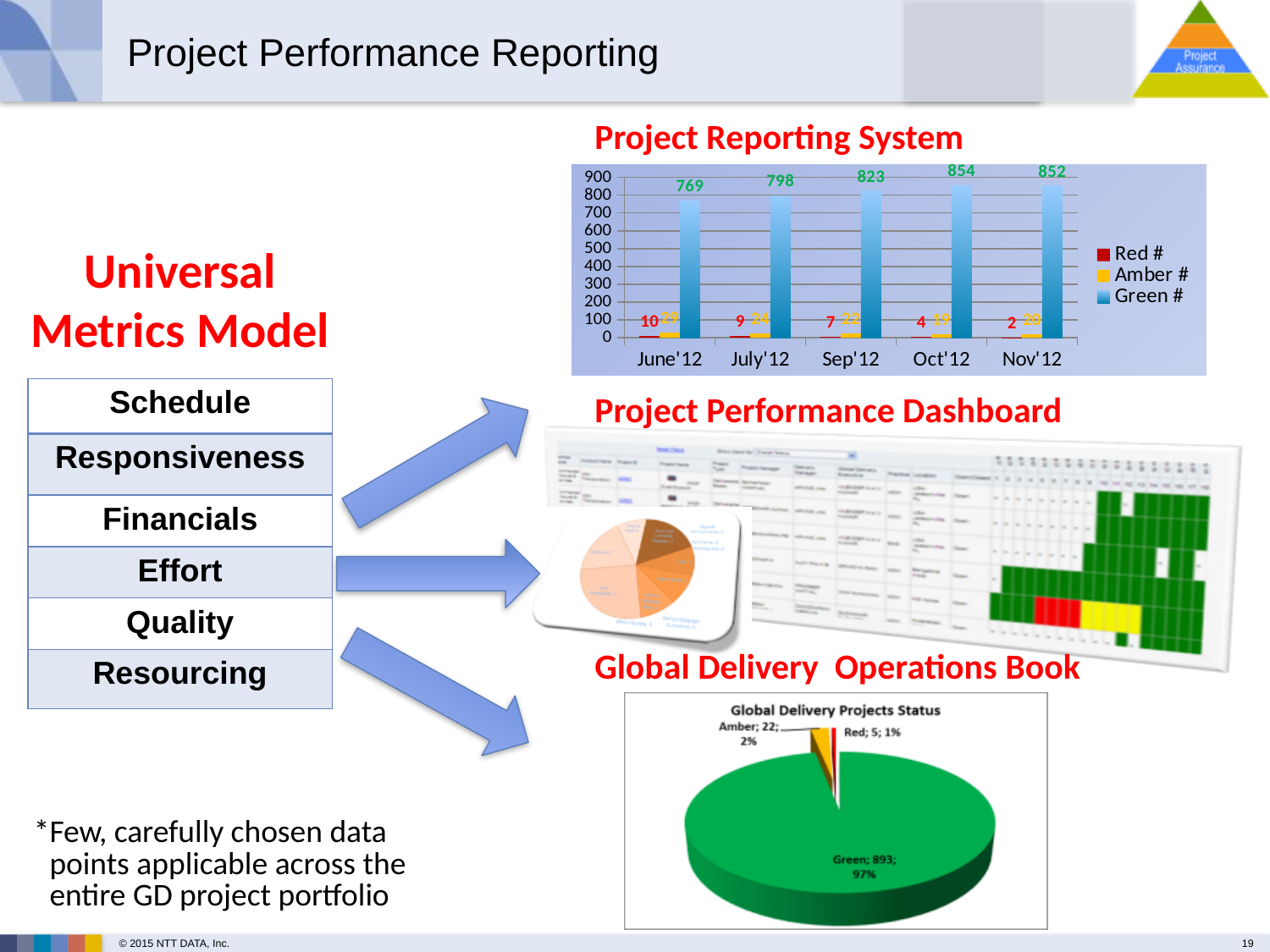
What kind of chart is the Project Reporting System chart? Bar chart In the Project Reporting System chart, what is the difference between the Green # values for Sep'12 and July'12? 25 In the Project Reporting System chart, does the Red # value rise or fall from June'12 to Nov'12? Fall In the Project Reporting System chart, how many series does the legend list? 3 In the Global Delivery Projects Status pie chart, what is the value for Amber? 22 In the Project Reporting System chart, which month has the highest Green # value? Oct'12 In the Project Reporting System chart, what is the Red # value for Nov'12? 2 In the Project Reporting System chart, what is the Green # value for June'12? 769 In the Global Delivery Projects Status pie chart, what share of the pie is Green? 97% In the Project Reporting System chart, what is the Green # value for Oct'12? 854 In the Project Reporting System chart, how many months are shown on the x axis? 5 In the Project Reporting System chart, which month has the lowest Green # value? June'12